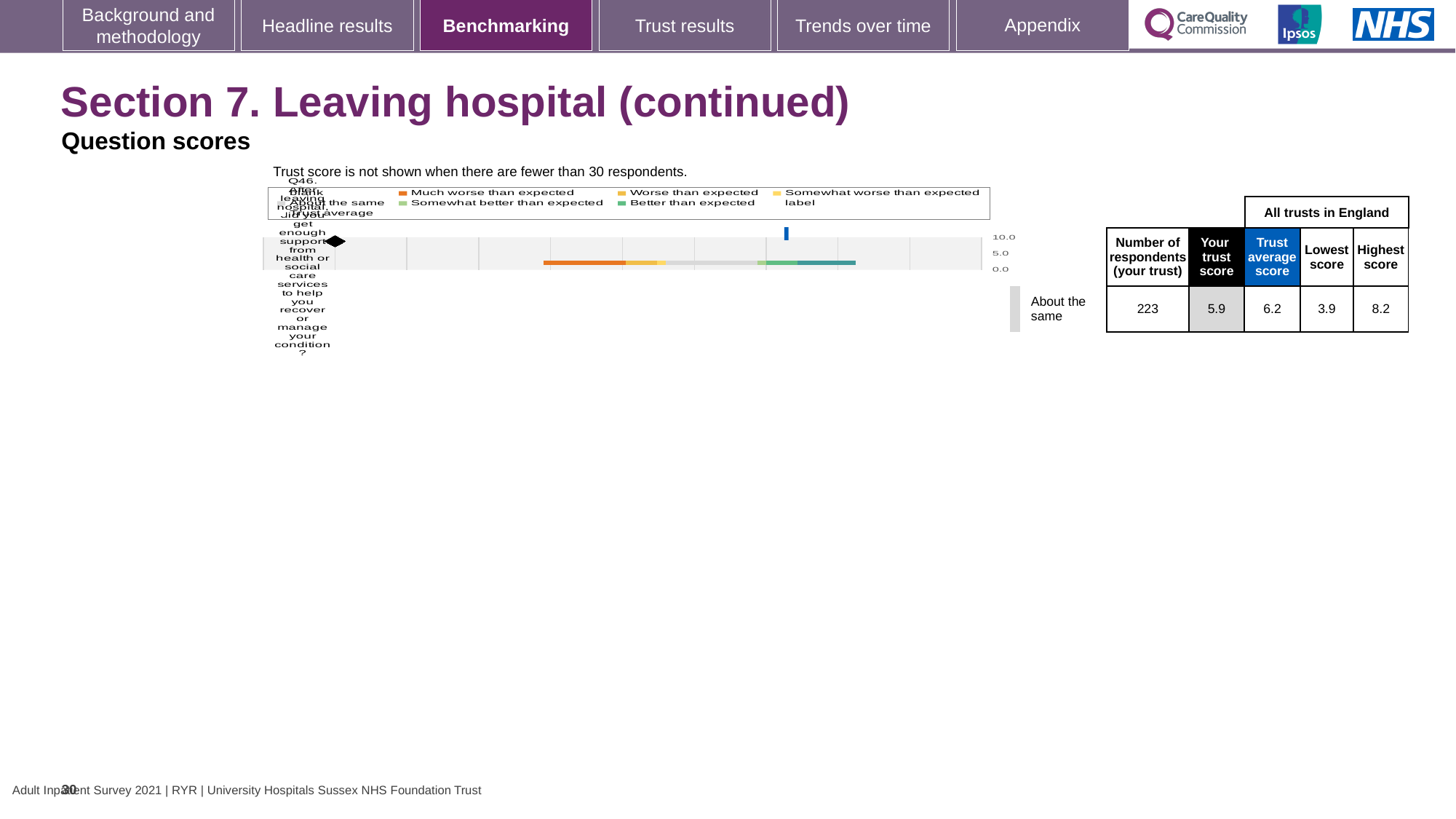
What is the trust average score for Q46? 6.2 What kind of chart is shown on the slide? Bar chart What is the lowest score among all trusts in England for Q46? 3.9 How many respondents from the trust answered Q46? 223 What is the highest score among all trusts in England for Q46? 8.2 Which is larger for Q46: your trust score or the trust average score? Trust average score What is the difference between the highest score and the lowest score for Q46? 4.3 What is the trust's score for Q46 (your trust score)? 5.9 Is the trust's score for Q46 greater or less than 5.0? greater What colour represents 'Much worse than expected' in the legend? Orange What benchmark category is the trust's Q46 result labelled as? About the same How many questions are plotted in the chart? 1